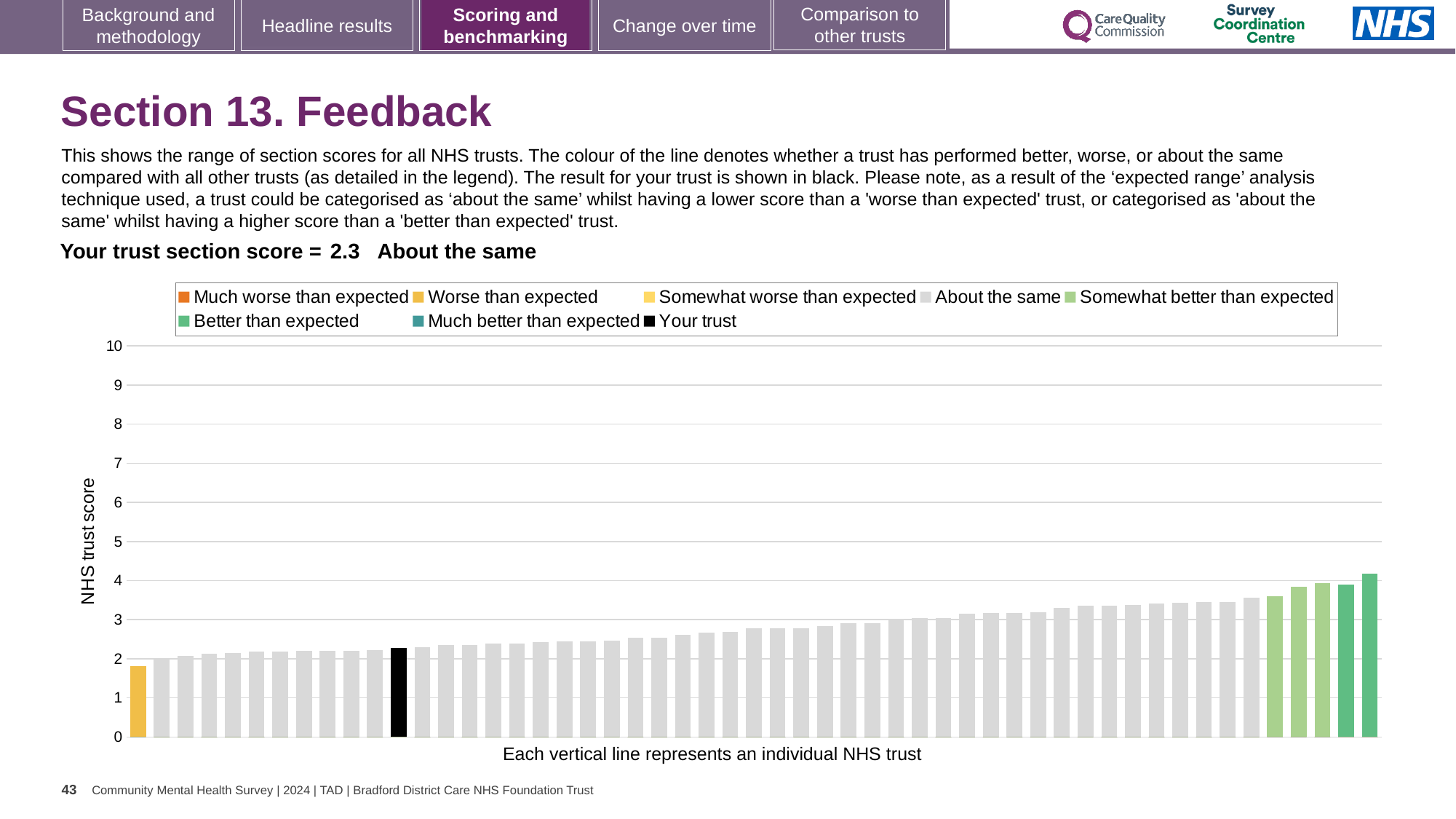
How many entries does the chart legend list? 8 What is the section score for your trust shown on the slide? 2.3 What kind of chart is shown on the slide? bar chart Which performance category is your trust placed in for this section? About the same What is the label of the y axis? NHS trust score Is the value of the leftmost bar greater or less than 2? less Is the value of the black 'Your trust' bar greater or less than 2? greater Is the value of the tallest bar greater or less than 5? less Do the bar values rise or fall from left to right along the x axis? rise What is the highest tick value shown on the y axis? 10